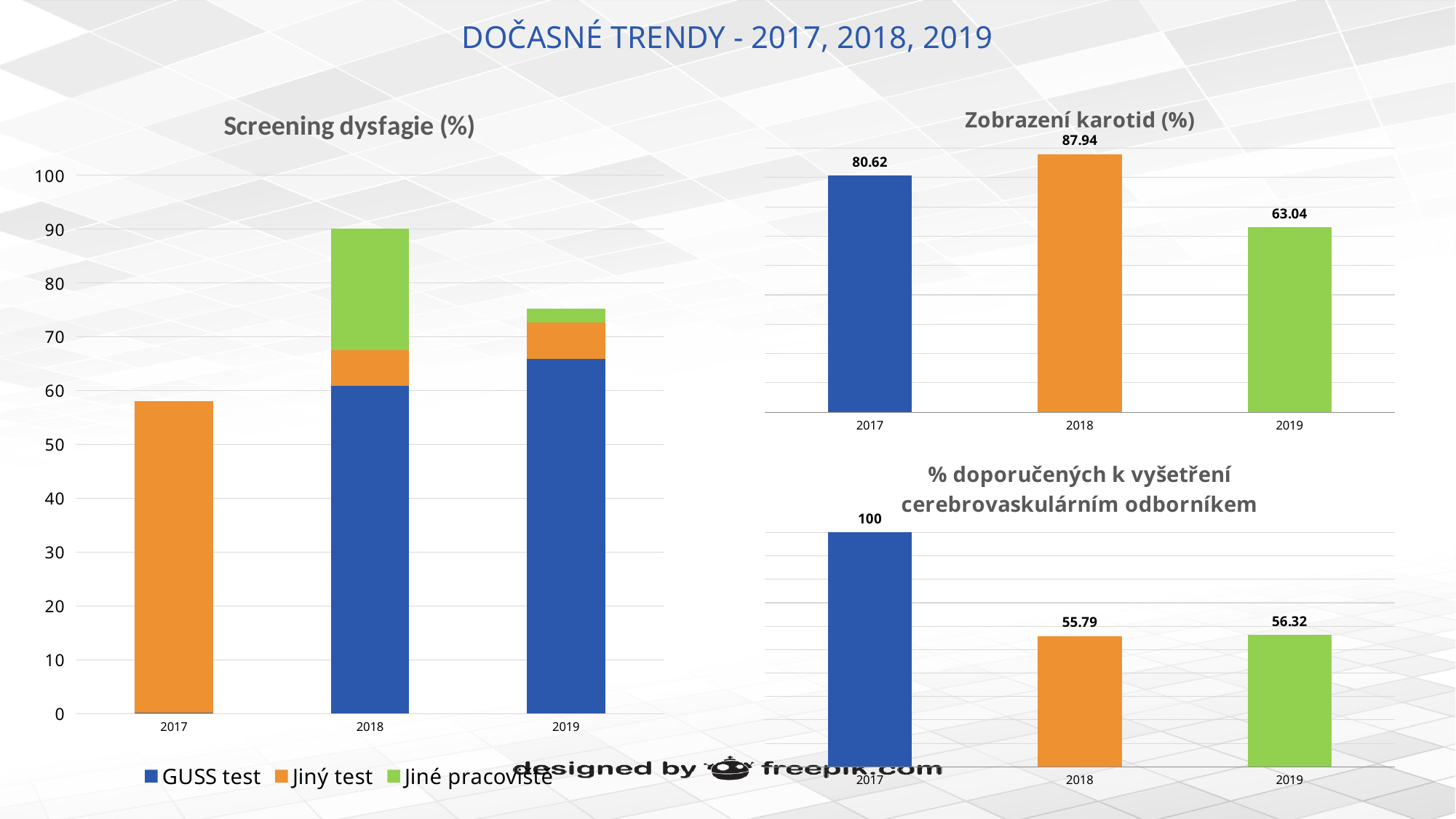
In the 'Screening dysfagie (%)' chart, is the total height of the 2018 stacked bar greater or less than 80? greater In the '% doporučených k vyšetření cerebrovaskulárním odborníkem' chart, which year has the larger value, 2018 or 2019? 2019 In the '% doporučených k vyšetření cerebrovaskulárním odborníkem' chart, what is the value for 2017? 100 In the 'Zobrazení karotid (%)' chart, how many years are shown? 3 In the 'Zobrazení karotid (%)' chart, what is the difference between the 2018 and 2019 values? 24.90 In the '% doporučených k vyšetření cerebrovaskulárním odborníkem' chart, which year has the highest value? 2017 In the 'Screening dysfagie (%)' chart, how many series does the legend list? 3 In the 'Zobrazení karotid (%)' chart, which year has the lowest value? 2019 In the 'Zobrazení karotid (%)' chart, what is the value for 2018? 87.94 In the 'Screening dysfagie (%)' chart, is the value for 'Jiný test' in 2017 greater or less than 50? greater In the '% doporučených k vyšetření cerebrovaskulárním odborníkem' chart, what is the difference between the 2017 and 2018 values? 44.21 What kind of chart is the 'Screening dysfagie (%)' chart? stacked bar chart